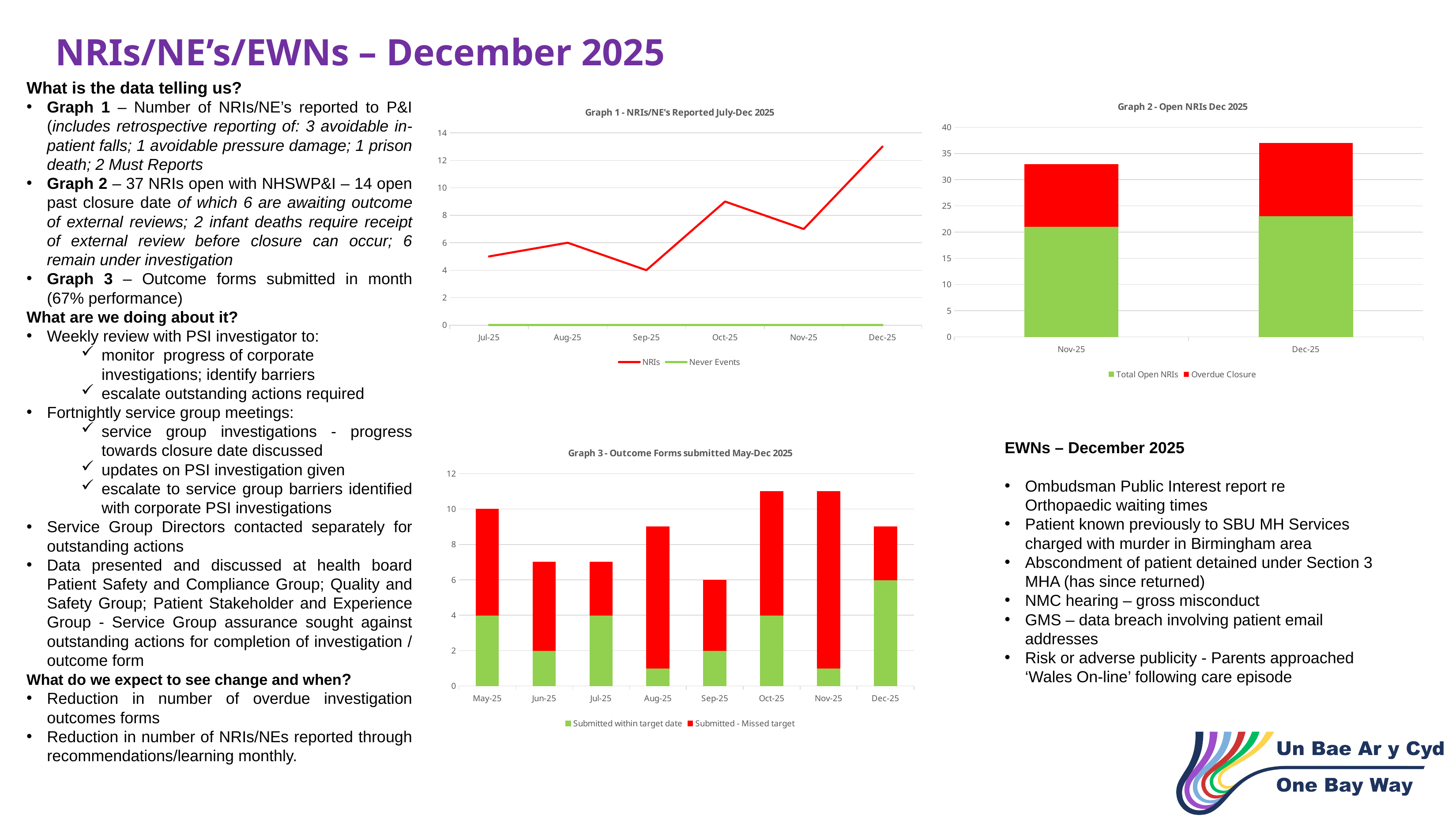
In Graph 2 - Open NRIs Dec 2025, is the total height of the Dec-25 bar greater or less than 35? greater In Graph 1 - NRIs/NE's Reported July-Dec 2025, is the NRIs value for Dec-25 greater or less than 12? greater What kind of chart is Graph 2 - Open NRIs Dec 2025? bar chart In Graph 1 - NRIs/NE's Reported July-Dec 2025, which month has the lowest NRIs value? Sep-25 In Graph 3 - Outcome Forms submitted May-Dec 2025, which month has the lowest total of outcome forms submitted? Sep-25 In Graph 3 - Outcome Forms submitted May-Dec 2025, what is the Submitted within target date value for Dec-25? 6 In Graph 2 - Open NRIs Dec 2025, which month has the taller stacked bar, Nov-25 or Dec-25? Dec-25 In Graph 1 - NRIs/NE's Reported July-Dec 2025, which month has the highest NRIs value? Dec-25 In Graph 1 - NRIs/NE's Reported July-Dec 2025, what is the NRIs value for Aug-25? 6 How many months are plotted on the x axis of Graph 1 - NRIs/NE's Reported July-Dec 2025? 6 What kind of chart is Graph 1 - NRIs/NE's Reported July-Dec 2025? line chart How many series does the legend of Graph 1 - NRIs/NE's Reported July-Dec 2025 list? 2